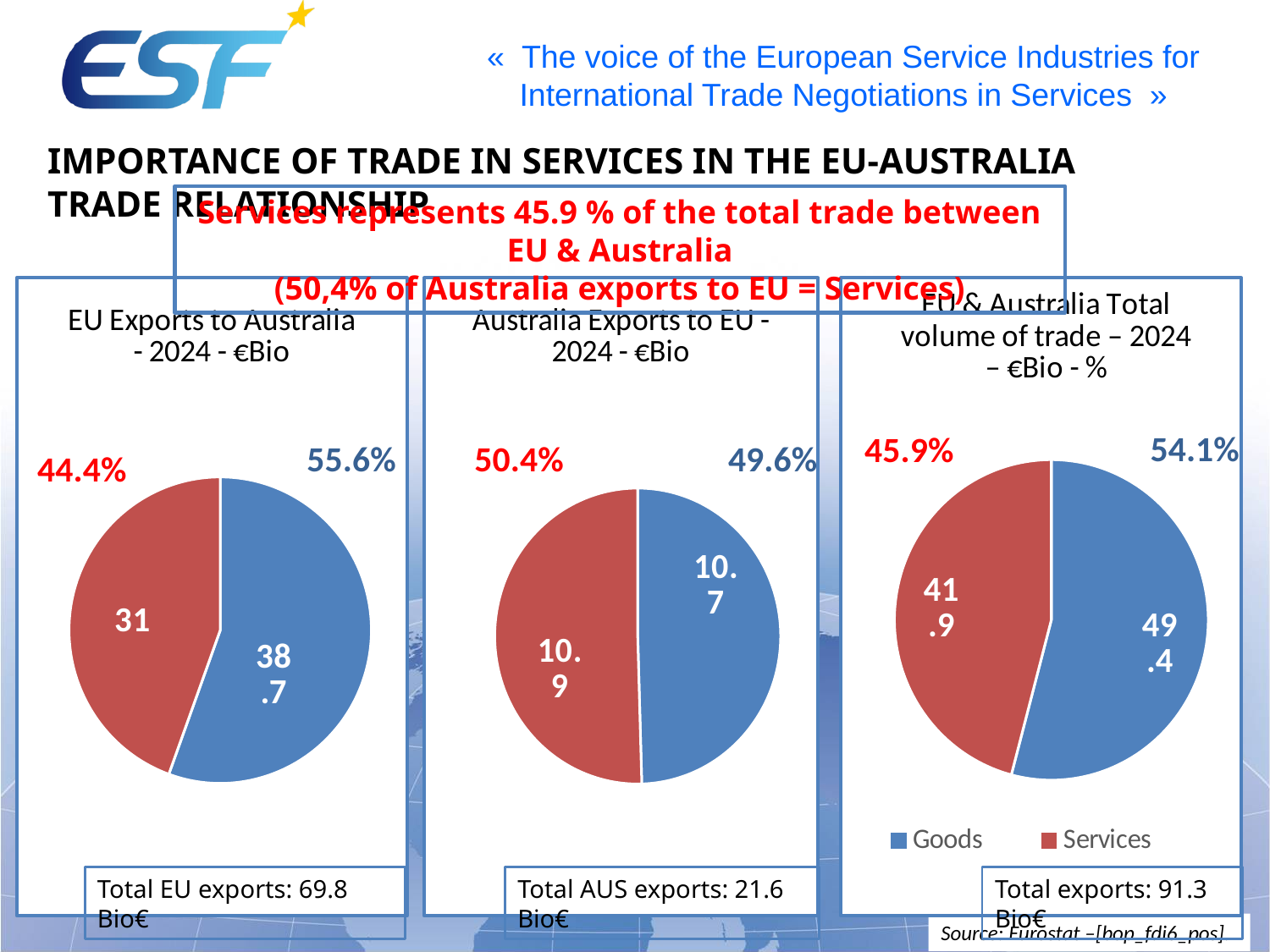
In the 'EU & Australia Total volume of trade – 2024 – €Bio - %' chart, what share of the pie is Services? 45.9% In the 'EU & Australia Total volume of trade – 2024 – €Bio - %' chart, which is larger, Goods or Services? Goods In the 'Australia Exports to EU - 2024 - €Bio' chart, what share of the pie is Goods? 49.6% What type of chart is used on the slide? Pie chart In the 'EU Exports to Australia - 2024 - €Bio' chart, which category is the largest? Goods In the 'EU Exports to Australia - 2024 - €Bio' chart, what is the difference between the Goods and Services values? 7.7 In the 'Australia Exports to EU - 2024 - €Bio' chart, what is the value for Services? 10.9 In the 'EU Exports to Australia - 2024 - €Bio' chart, what is the value for Goods? 38.7 In the 'EU Exports to Australia - 2024 - €Bio' chart, what share of the pie is Services? 44.4% In the 'EU & Australia Total volume of trade – 2024 – €Bio - %' chart, what is the value for Goods? 49.4 In the 'EU Exports to Australia - 2024 - €Bio' chart, what is the value for Services? 31 How many series does the legend on the slide list? 2